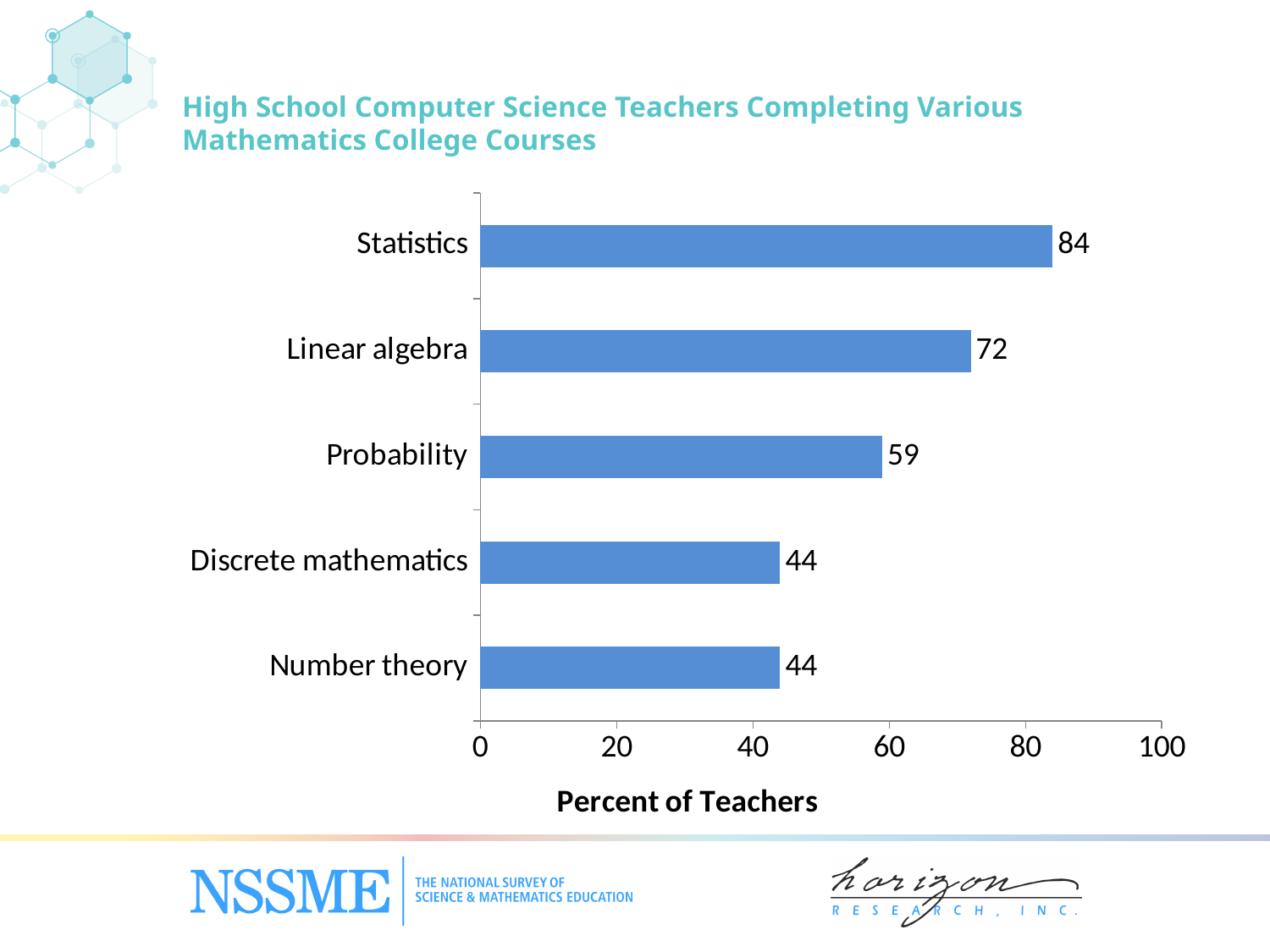
What is the value for Discrete mathematics? 44 What is the label of the horizontal axis? Percent of Teachers Is the value for Probability greater or less than 40? greater What is the difference between the values for Statistics and Linear algebra? 12 What percent of teachers completed a Statistics course? 84 What is the value for Linear algebra? 72 What is the difference between the values for Probability and Number theory? 15 What percent of teachers completed a Probability course? 59 Which course has the highest percent of teachers? Statistics Which is larger, the value for Linear algebra or the value for Probability? Linear algebra How many courses are shown in the chart? 5 What kind of chart is shown on the slide? Bar chart